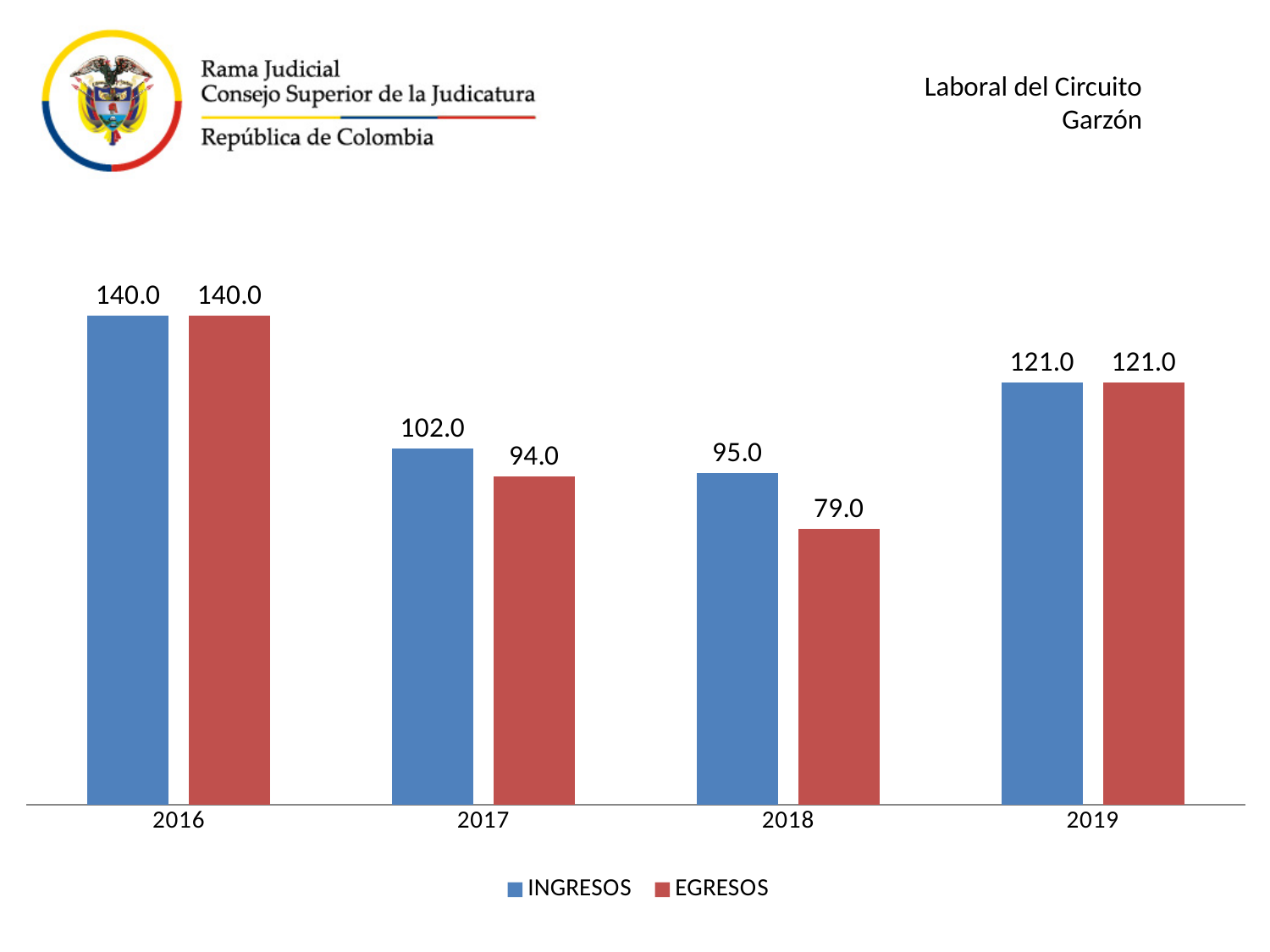
What kind of chart is shown on the slide? Bar chart How many years are shown on the x axis? 4 What is the difference between INGRESOS and EGRESOS in 2018? 16.0 What is the EGRESOS value for 2018? 79.0 What is the EGRESOS value for 2016? 140.0 What is the difference between the INGRESOS values for 2016 and 2017? 38.0 How many series does the legend list? 2 Which is larger in 2017, INGRESOS or EGRESOS? INGRESOS What is the INGRESOS value for 2019? 121.0 Which year has the lowest EGRESOS value? 2018 What is the INGRESOS value for 2017? 102.0 Which year has the highest INGRESOS value? 2016